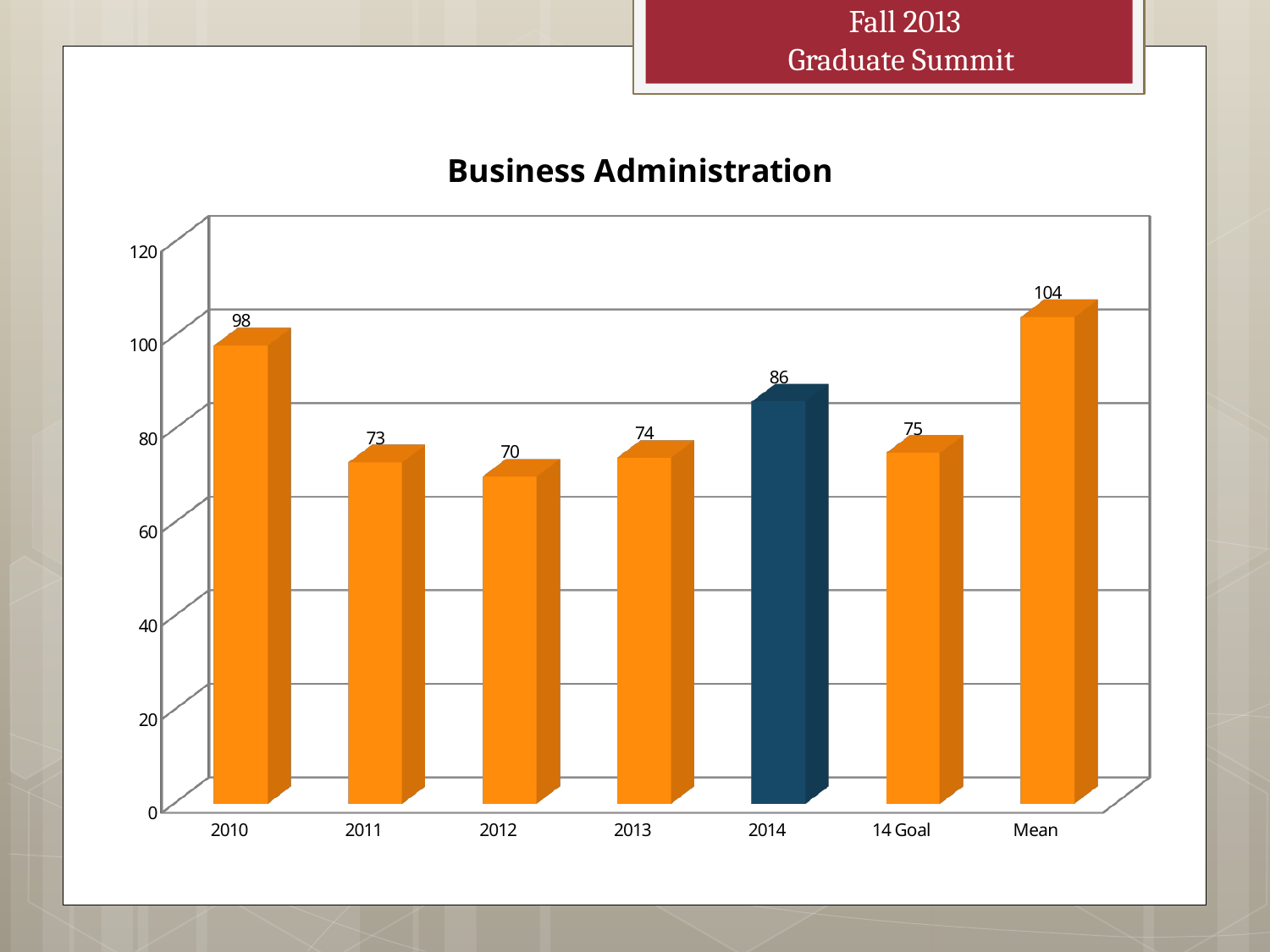
Is the value for 2010 greater or less than 80? greater What is the value for 2010? 98 What is the value for Mean? 104 What is the difference between the values for 2014 and 14 Goal? 11 How many categories are shown on the x axis? 7 Which category has the lowest value? 2012 What is the value for 2014? 86 Which category has the highest value? Mean Which is larger, the value for 2011 or the value for 2013? 2013 What kind of chart is this? bar chart What is the title of the chart? Business Administration What is the value for 14 Goal? 75